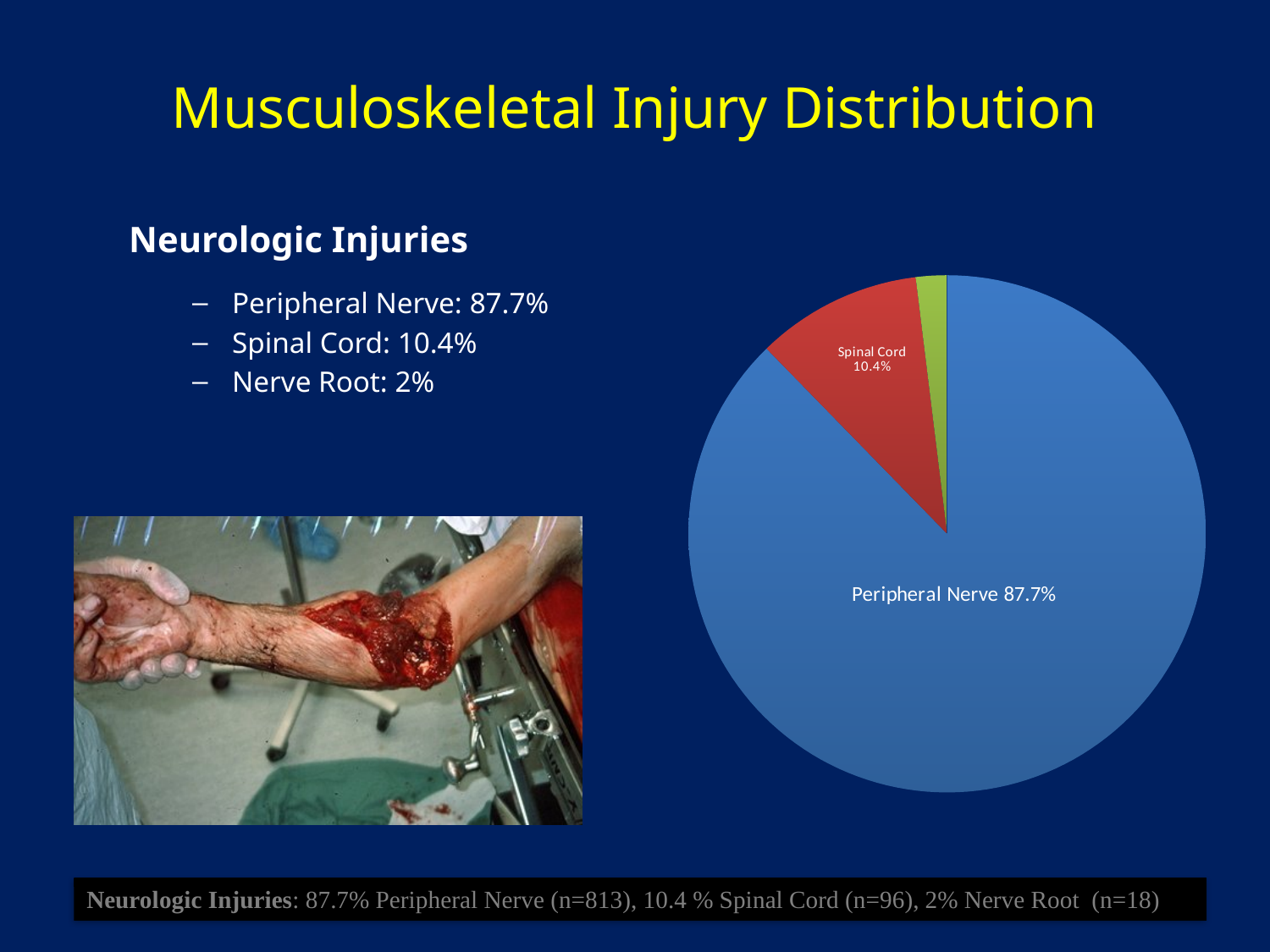
What share of the pie does Peripheral Nerve represent? 87.7% What kind of chart is shown on the slide? pie chart What share of the pie does Spinal Cord represent? 10.4% What colour is the Spinal Cord slice in the pie chart? red Which slice of the pie chart is the smallest? Nerve Root What is the difference in percentage points between the Spinal Cord and Nerve Root slices? 8.4 How many slices does the pie chart have? 3 Which is larger, the Spinal Cord slice or the Peripheral Nerve slice? Peripheral Nerve What is the difference in percentage points between the Peripheral Nerve and Spinal Cord slices? 77.3 What colour is the Peripheral Nerve slice in the pie chart? blue According to the slide, what percentage of neurologic injuries are Nerve Root injuries? 2% Which slice of the pie chart is the largest? Peripheral Nerve